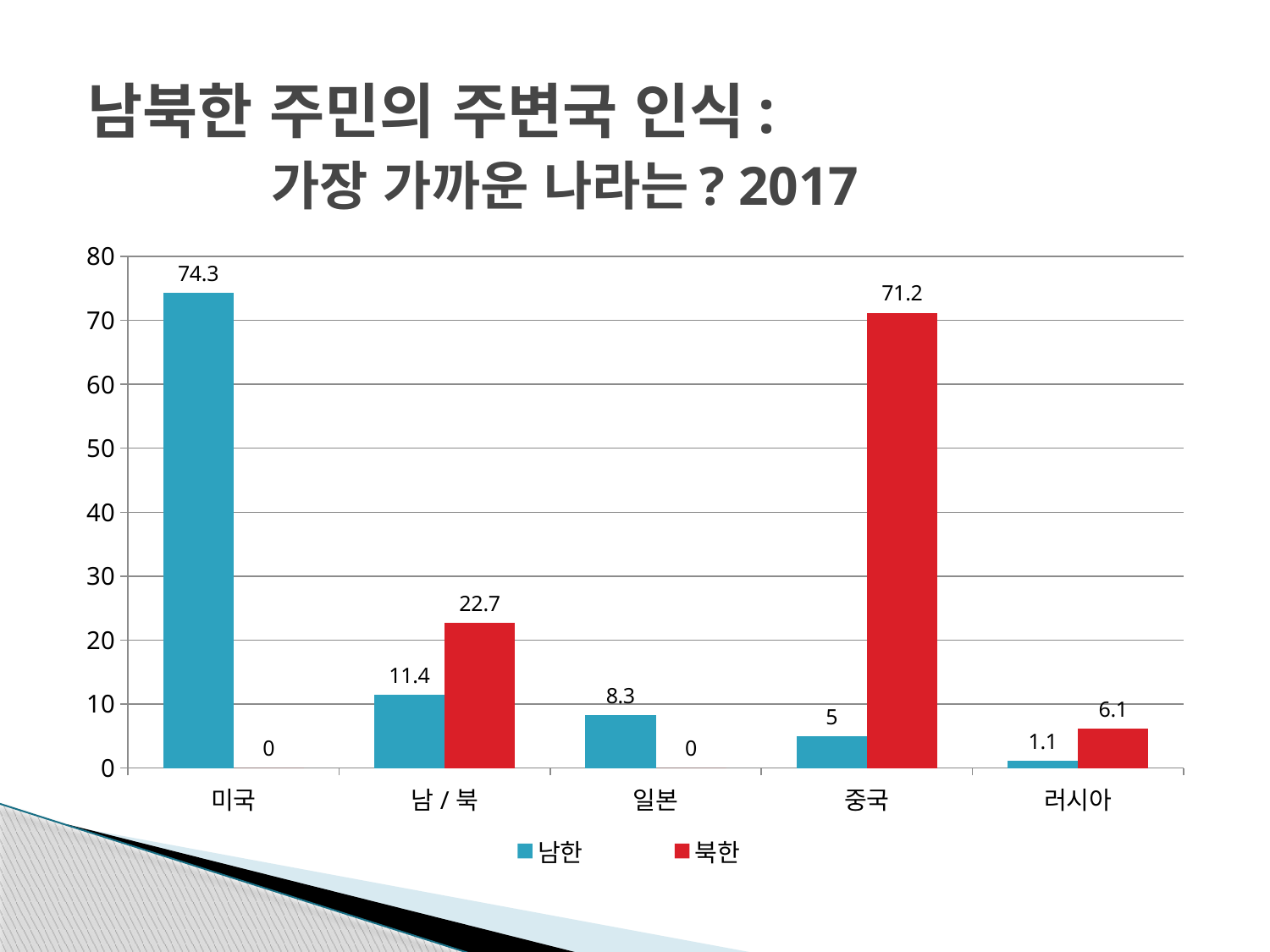
What is the difference between the 남한 and 북한 values in the 남 / 북 category? 11.3 What is the value for 북한 in the 중국 category? 71.2 What is the value for 북한 in the 남 / 북 category? 22.7 What kind of chart is shown on the slide? Bar chart Which colour represents the 북한 series? Red What is the value for 남한 in the 일본 category? 8.3 Which category has the lowest value for the 남한 series? 러시아 Which is larger: the 남한 value for 미국 or the 북한 value for 중국? 남한 value for 미국 How many series does the legend list? 2 Which category has the highest value for the 남한 series? 미국 What is the value for 남한 in the 미국 category? 74.3 How many categories are shown on the x axis? 5